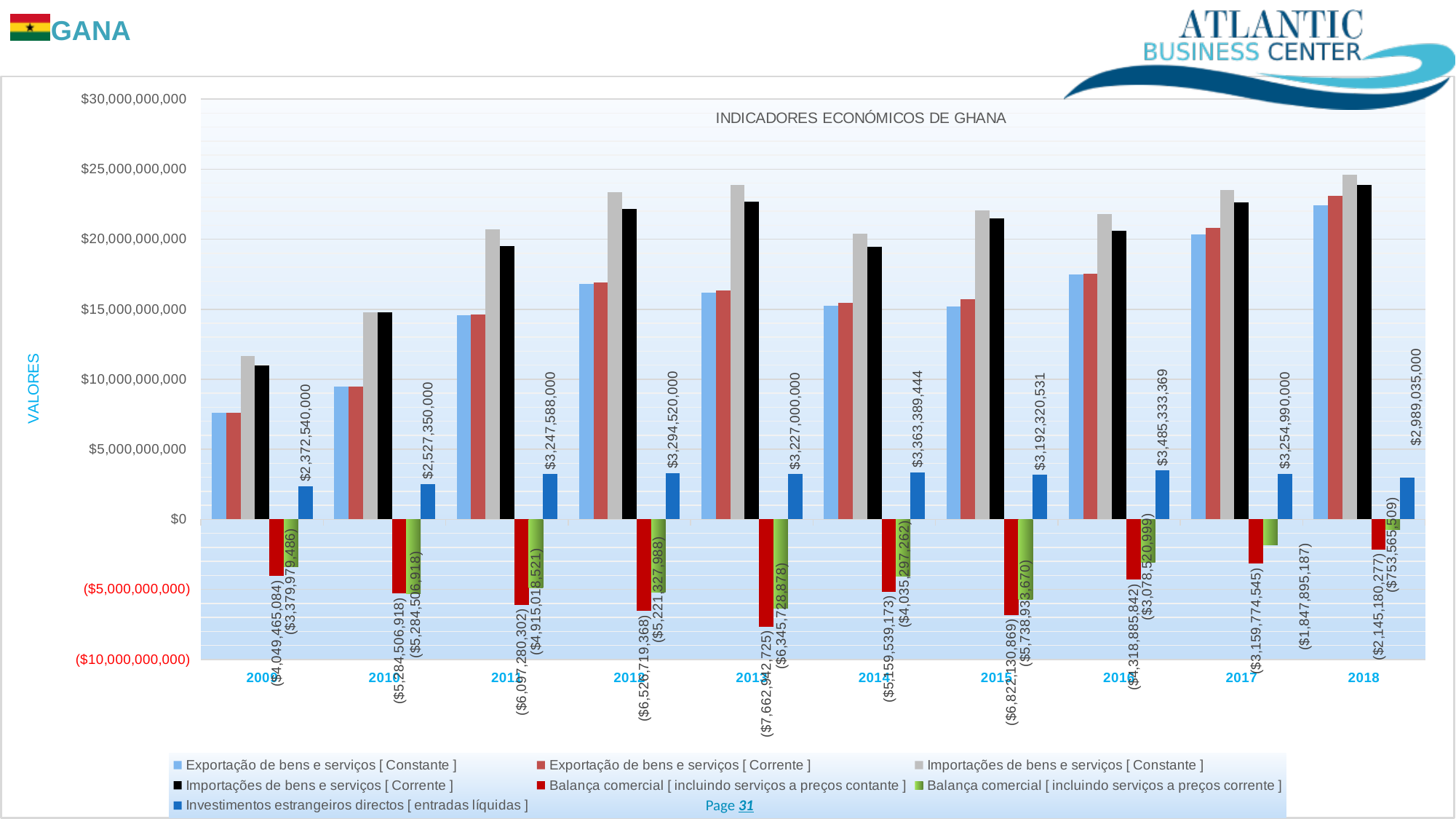
What is the value of Investimentos estrangeiros directos [ entradas líquidas ] for 2009? $2,372,540,000 What is the title of the chart? INDICADORES ECONÓMICOS DE GHANA In which year is Investimentos estrangeiros directos [ entradas líquidas ] highest? 2016 What is the value of Investimentos estrangeiros directos [ entradas líquidas ] for 2016? $3,485,333,369 How many years are shown on the x axis of the chart? 10 How many series does the chart legend list? 7 What is the value of Balança comercial [ incluindo serviços a preços corrente ] for 2018? ($753,565,509) Is the value of Importações de bens e serviços [ Constante ] for 2018 greater or less than $20,000,000,000? greater In 2018, which is larger: Importações de bens e serviços [ Constante ] or Exportação de bens e serviços [ Constante ]? Importações de bens e serviços [ Constante ] What kind of chart is shown on the slide? Bar chart What is the difference between Investimentos estrangeiros directos [ entradas líquidas ] in 2010 and in 2009? $154,810,000 In which year is Investimentos estrangeiros directos [ entradas líquidas ] lowest? 2009